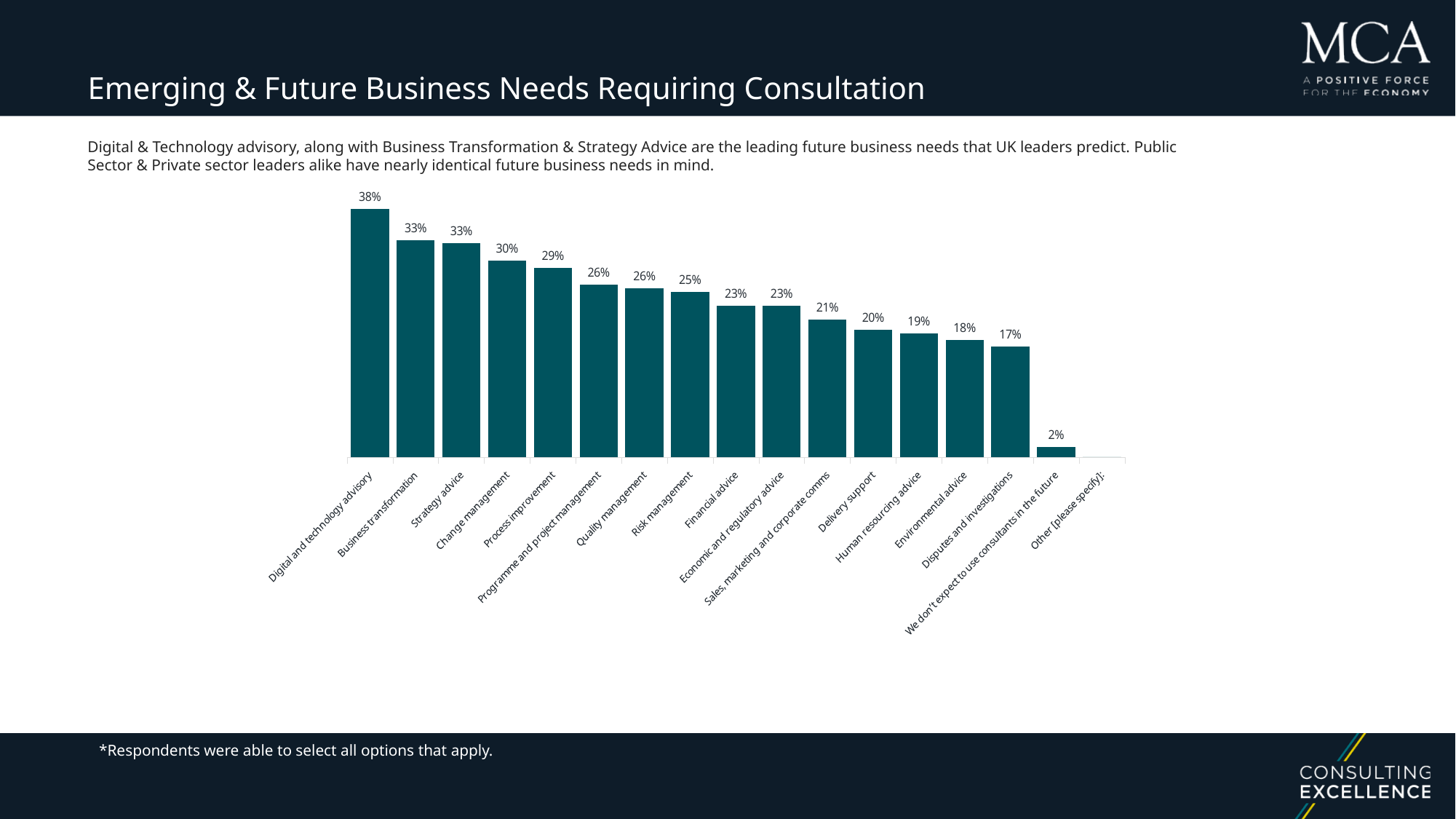
What is the value for Digital and technology advisory? 38% What is the value for Change management? 30% What is the difference between the values for Digital and technology advisory and Business transformation? 5% What is the title of the slide containing the chart? Emerging & Future Business Needs Requiring Consultation What type of chart is shown on the slide? Bar chart What is the value for Disputes and investigations? 17% What is the value for 'We don't expect to use consultants in the future'? 2% Which category has the highest value? Digital and technology advisory Which is larger, the value for Sales, marketing and corporate comms or the value for Environmental advice? Sales, marketing and corporate comms What is the value for Risk management? 25% What is the difference between the values for Process improvement and Delivery support? 9% Do the values generally rise or fall moving from left to right along the x axis? Fall